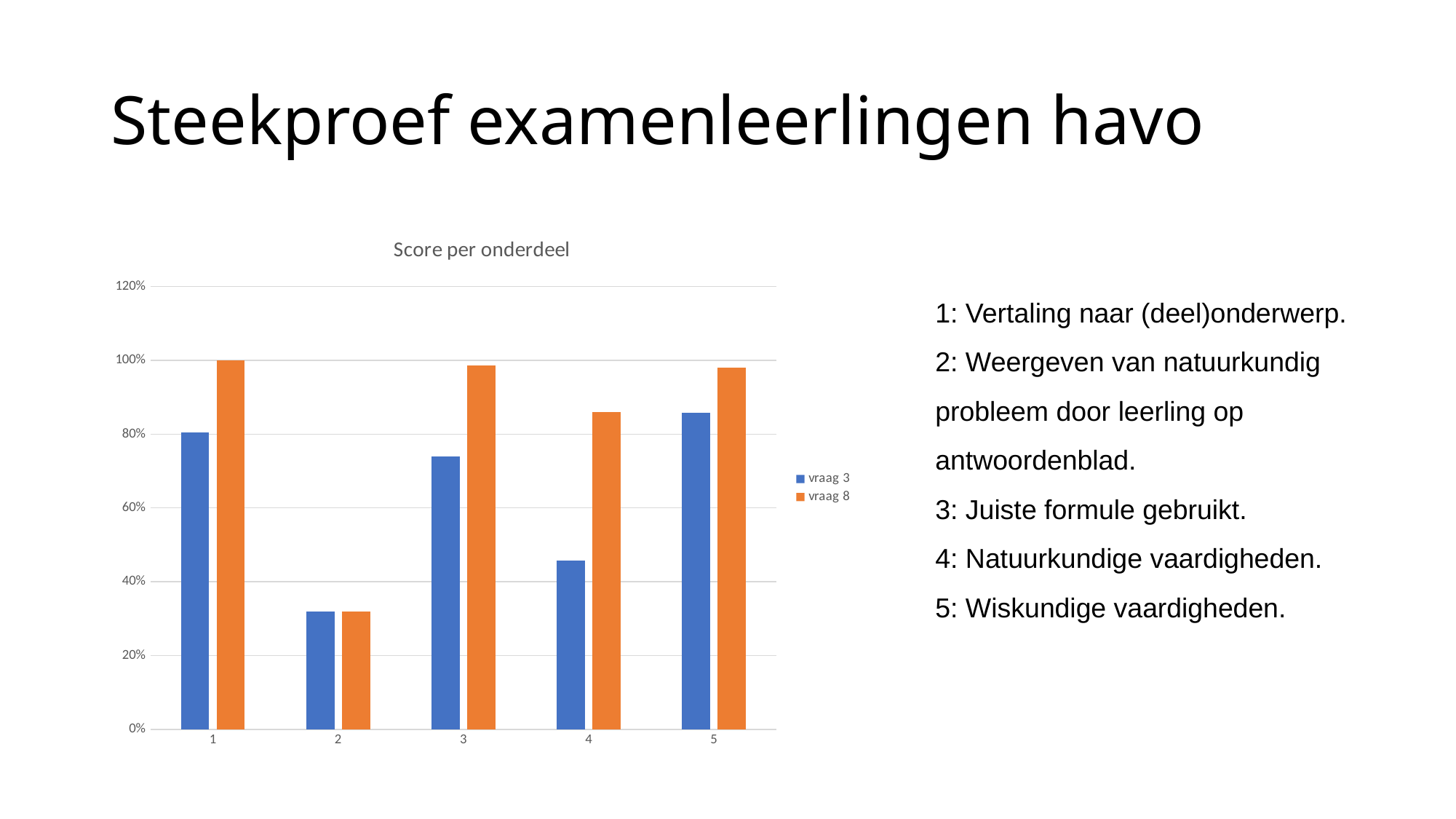
For category 4, which series has the larger value, vraag 3 or vraag 8? vraag 8 Is the vraag 3 value for category 4 greater or less than 40%? greater How many categories are shown on the x axis of the chart? 5 What is the title of the chart? Score per onderdeel For which category is the vraag 3 value the highest? 5 How many series does the chart legend list? 2 For which category is the vraag 8 value the lowest? 2 Is the vraag 3 value for category 2 greater or less than 40%? less Which series are listed in the chart legend? vraag 3 and vraag 8 For which category is the vraag 3 value the lowest? 2 Is the vraag 8 value for category 3 greater or less than 80%? greater What type of chart is shown on the slide? bar chart